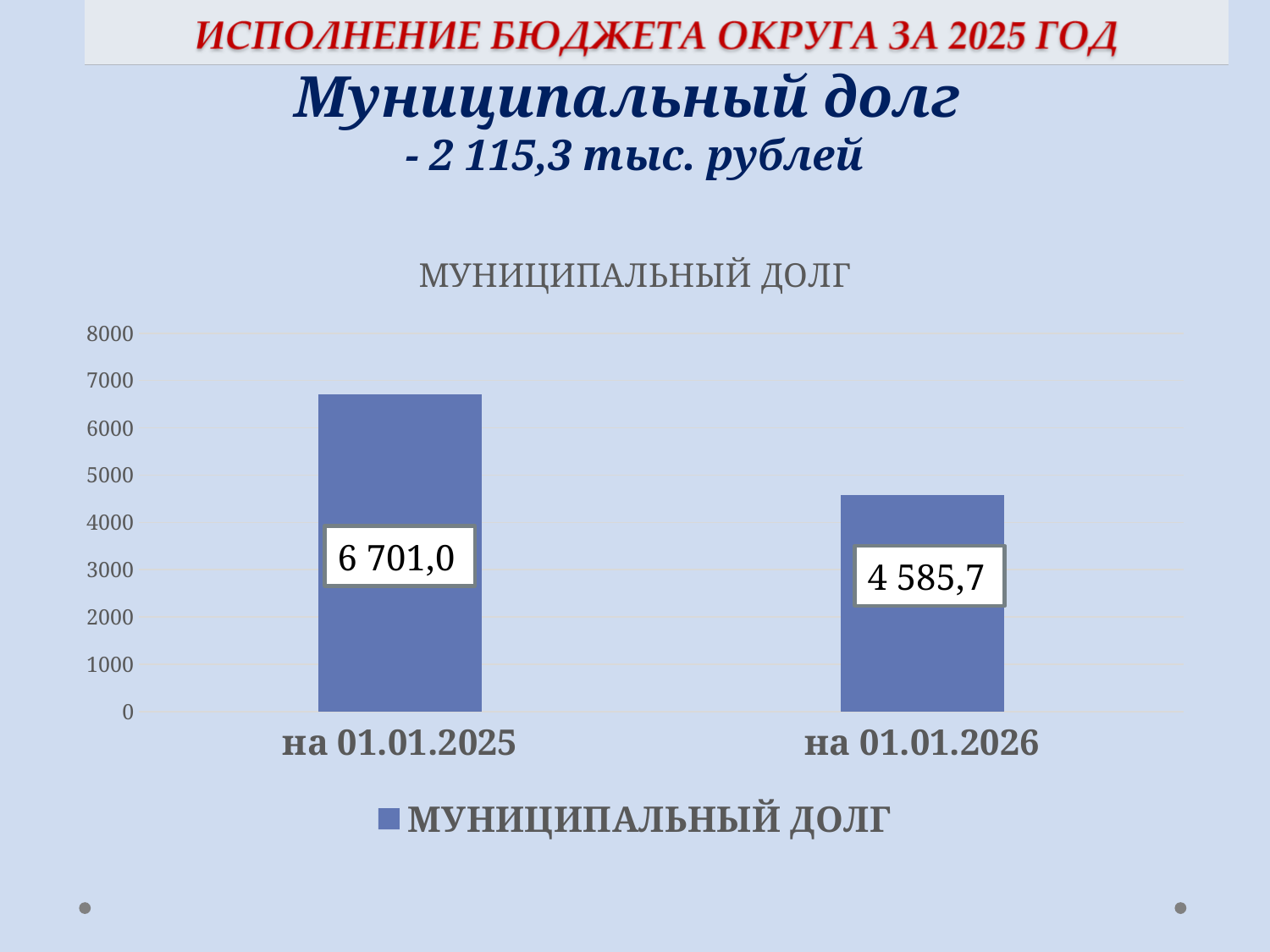
Is the value for "на 01.01.2025" greater or less than 6000? greater How many series does the legend list? 1 Which is larger: the value for "на 01.01.2025" or for "на 01.01.2026"? на 01.01.2025 Is the value for "на 01.01.2026" greater or less than 5000? less What is the value for "на 01.01.2025"? 6 701,0 How many categories are shown on the x axis? 2 What is the difference between the values for "на 01.01.2025" and "на 01.01.2026"? 2 115,3 What is the title of the chart? МУНИЦИПАЛЬНЫЙ ДОЛГ What is the value for "на 01.01.2026"? 4 585,7 What kind of chart is shown? bar chart Which category has the lowest value? на 01.01.2026 Which category has the highest value? на 01.01.2025